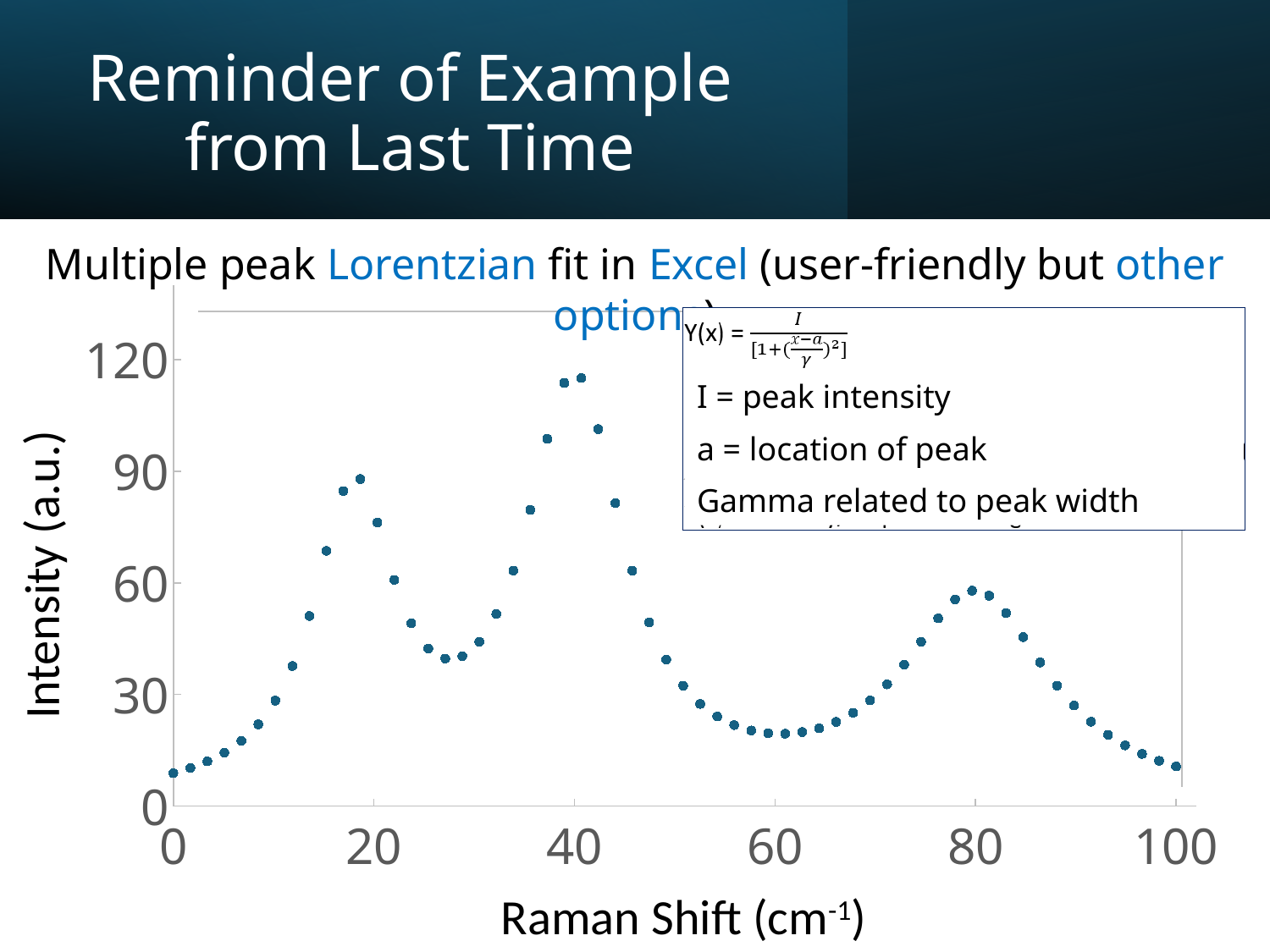
What is the label of the y axis of the chart? Intensity (a.u.) Near which x-axis tick does the intensity reach its highest value? 40 Is the intensity at a Raman shift of 40 greater or less than 90? greater Which peak is higher: the one near a Raman shift of 40 or the one near 80? The one near 40 Is the intensity at a Raman shift of 60 greater or less than 30? less What kind of chart is shown on the slide? Scatter chart Which peak is higher: the one near a Raman shift of 20 or the one near 80? The one near 20 What is the label of the x axis of the chart? Raman Shift (cm-1) Is the intensity at a Raman shift of 20 greater or less than 60? greater